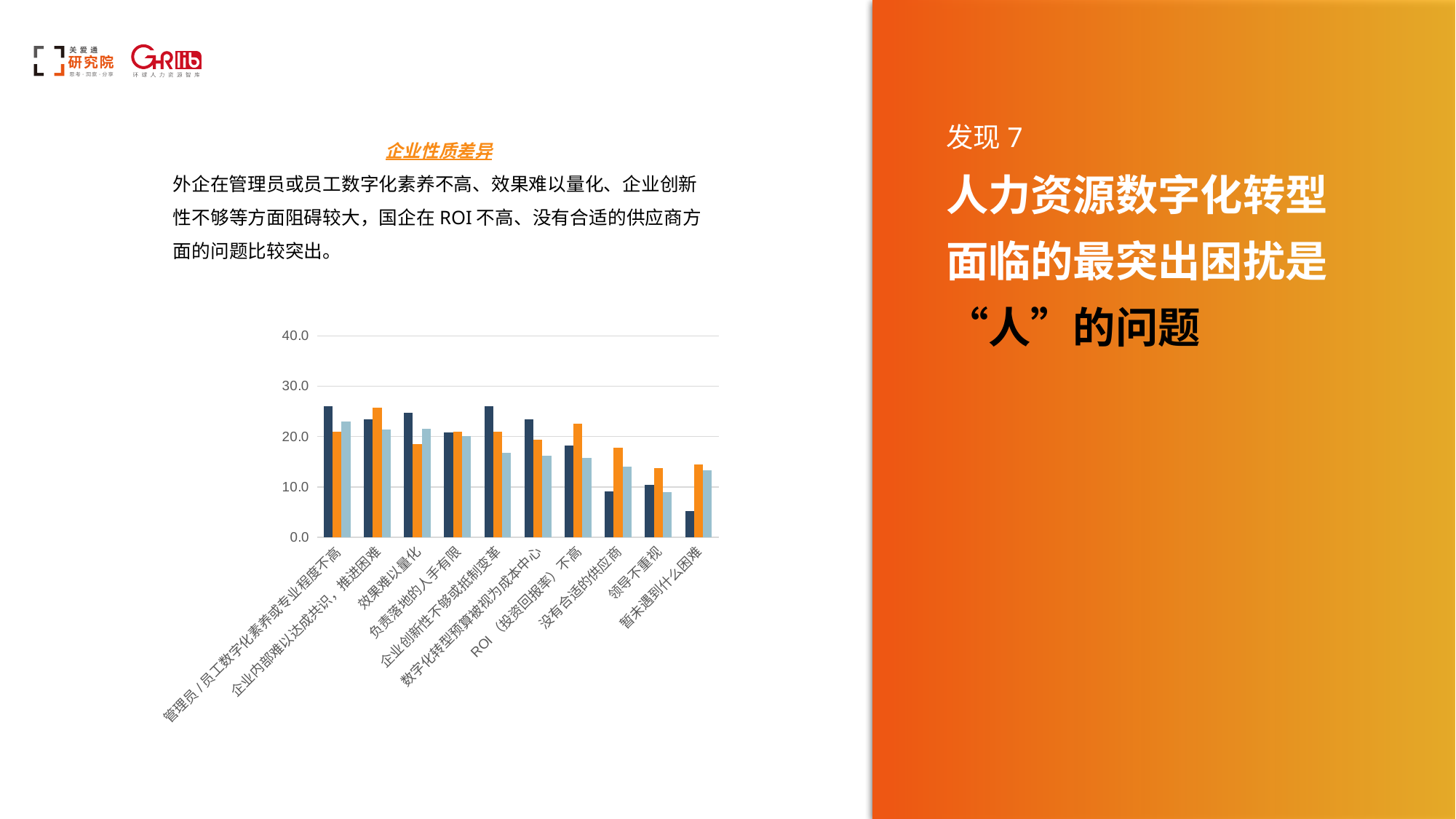
Which category has the highest orange bar? 企业内部难以达成共识，推进困难 Which category has the lowest dark navy bar? 暂未遇到什么困难 For 效果难以量化, which bar is larger: the dark navy bar or the orange bar? the dark navy bar What is the heading shown above the chart? 企业性质差异 How many categories are shown on the x axis of the chart? 10 For 暂未遇到什么困难, which bar is larger: the dark navy bar or the orange bar? the orange bar Is the dark navy bar for 暂未遇到什么困难 greater or less than 10.0? less Is the dark navy bar for 管理员/员工数字化素养或专业程度不高 greater or less than 20.0? greater Is the orange bar for 企业内部难以达成共识，推进困难 greater or less than 20.0? greater What kind of chart is shown on the slide? bar chart How many bars (series) are plotted for each category in the chart? 3